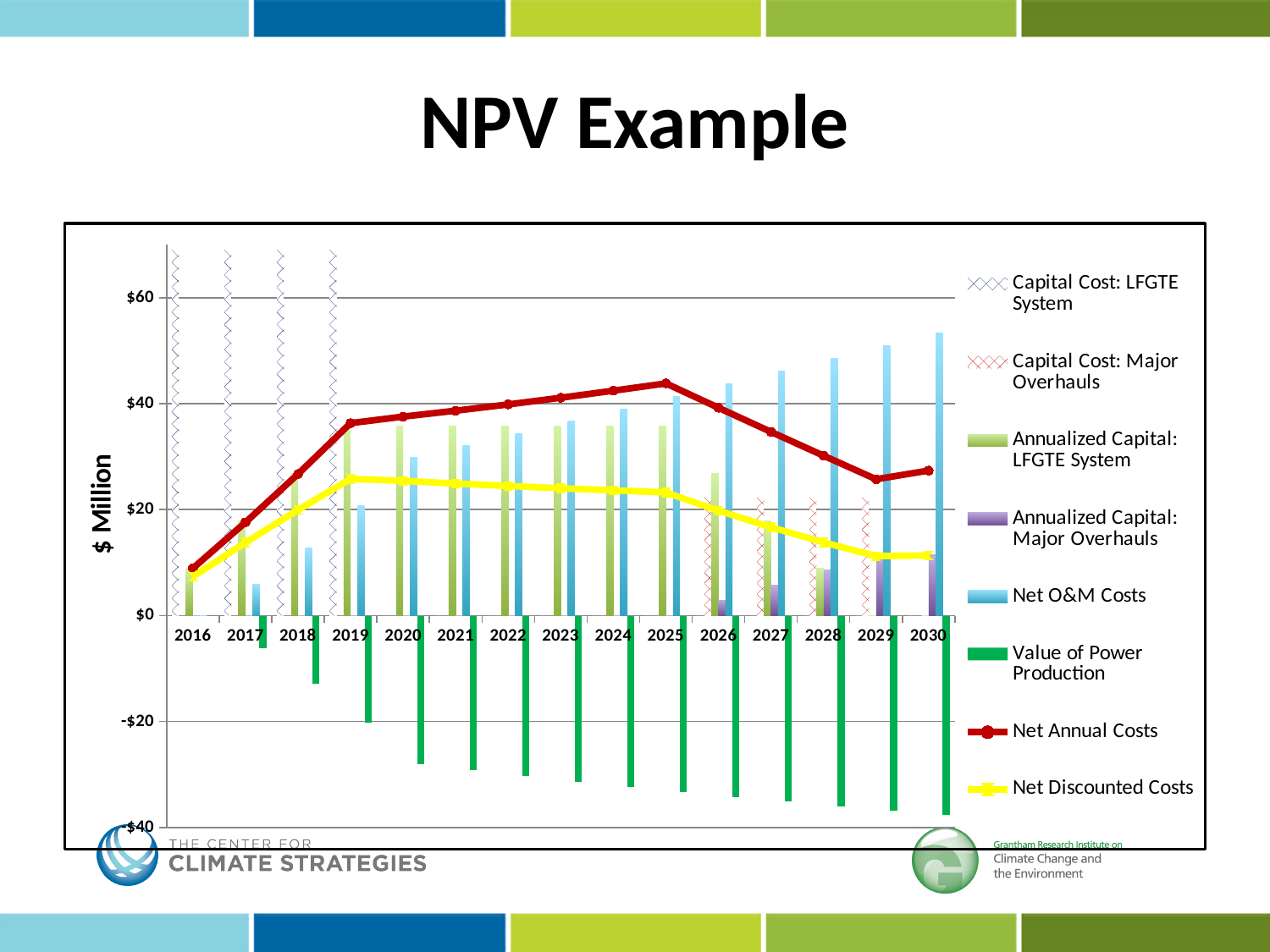
Is the Net O&M Costs value for 2030 greater or less than $40? greater What is the label on the vertical axis of the chart? $ Million How many years are shown along the x axis of the chart? 15 Is the Net Discounted Costs value for 2019 greater or less than $20? greater What kind of chart is shown on the slide? A combined bar and line chart Do the Net O&M Costs bars generally rise or fall from 2017 to 2030? rise In which year does the Net Annual Costs line reach its highest value? 2025 How many series does the chart's legend list? 8 In which year is the Net O&M Costs bar the tallest? 2030 Which is larger, the Net Annual Costs value for 2025 or for 2029? 2025 In which year is the Net Annual Costs line at its lowest value? 2016 What is the title of the slide containing the chart? NPV Example